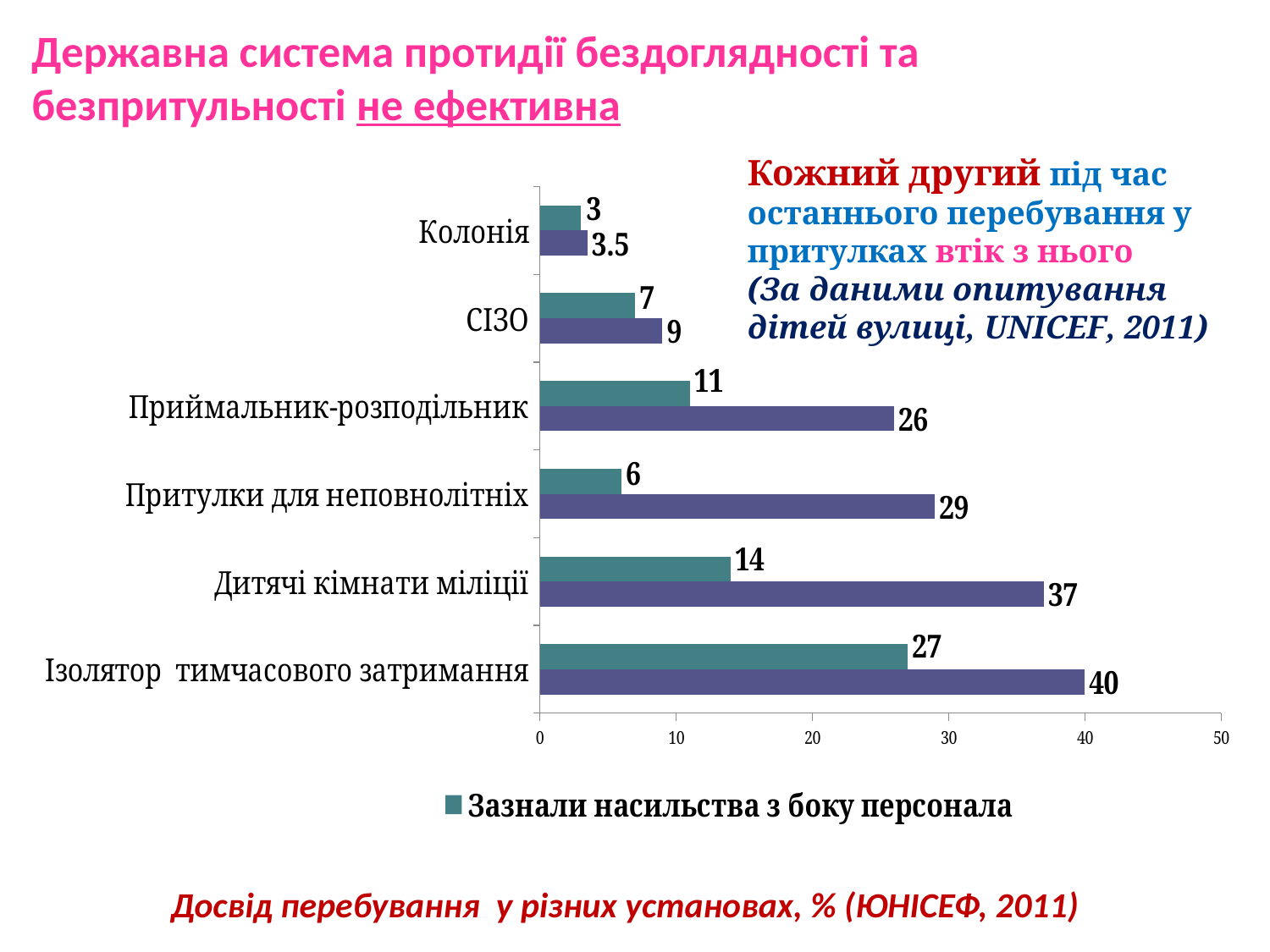
What is the value of 'Зазнали насильства з боку персонала' for 'Дитячі кімнати міліції'? 14 Which category has the lowest value for 'Зазнали насильства з боку персонала'? Колонія What is the difference between the purple bar and the 'Зазнали насильства з боку персонала' bar for 'Приймальник-розподільник'? 15 How many categories (institutions) are shown on the chart? 6 Which category has the highest value for 'Зазнали насильства з боку персонала'? Ізолятор тимчасового затримання What is the caption printed below the chart? Досвід перебування у різних установах, % (ЮНІСЕФ, 2011) Which is larger for 'СІЗО': the purple bar or the 'Зазнали насильства з боку персонала' bar? the purple bar What type of chart is shown on the slide? bar chart What is the value of the purple bar for 'Колонія'? 3.5 How many series does the chart legend list? 1 What is the value of 'Зазнали насильства з боку персонала' for 'Ізолятор тимчасового затримання'? 27 What is the value of the purple bar for 'Притулки для неповнолітніх'? 29